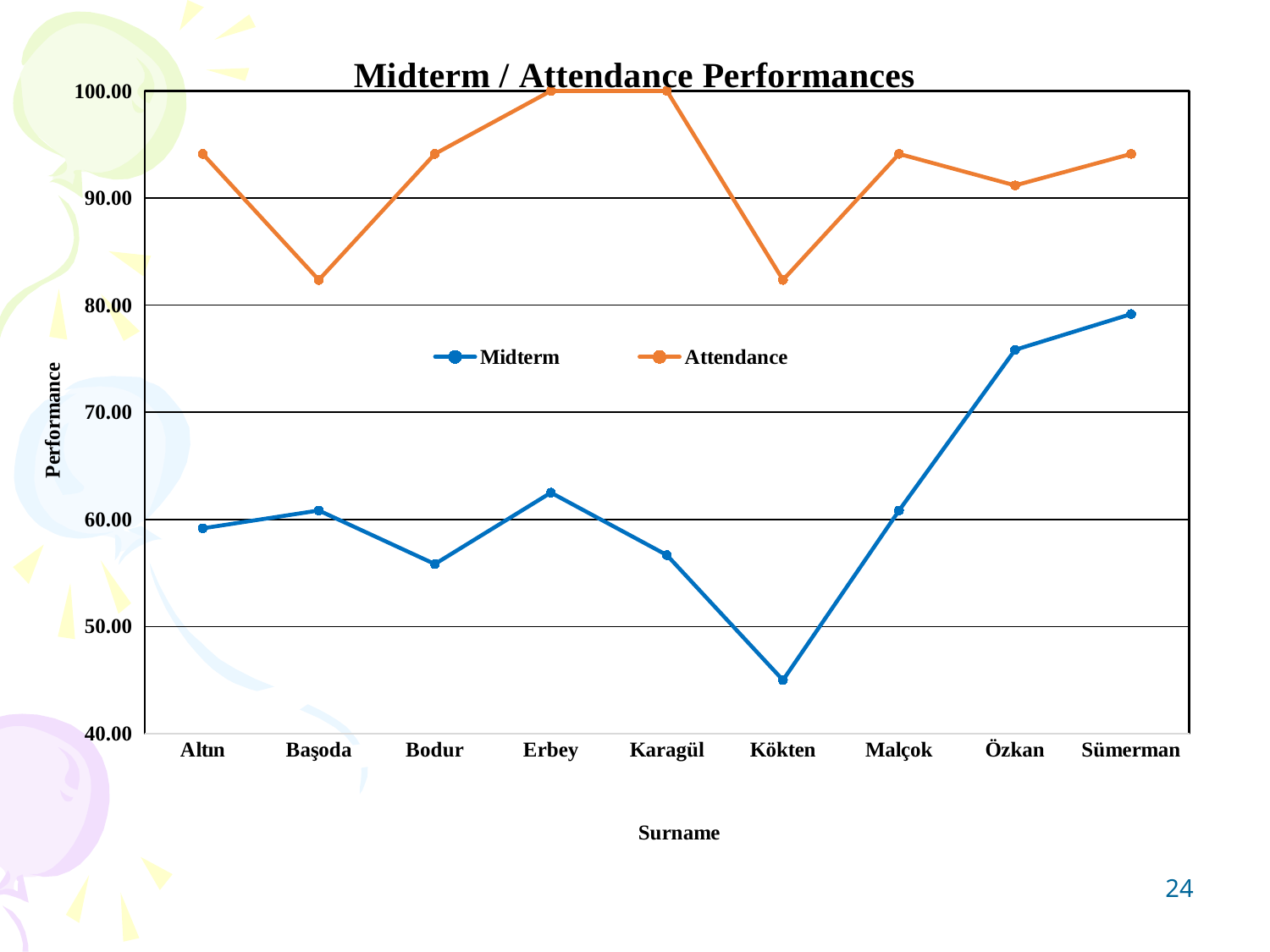
How many surnames are plotted along the x axis? 9 What is the label of the y axis? Performance Which surname has the highest Midterm value? Sümerman What kind of chart is shown on the slide? line chart Is the Attendance value for Başoda greater or less than 90.00? less Do the Midterm values rise or fall from Kökten to Sümerman? rise What is the Attendance value for Erbey? 100.00 Which surname has the lowest Midterm value? Kökten Is the Midterm value for Kökten greater or less than 50.00? less How many series does the legend list? 2 What is the title of the chart? Midterm / Attendance Performances Which is larger, the Midterm value for Özkan or the Midterm value for Malçok? Özkan